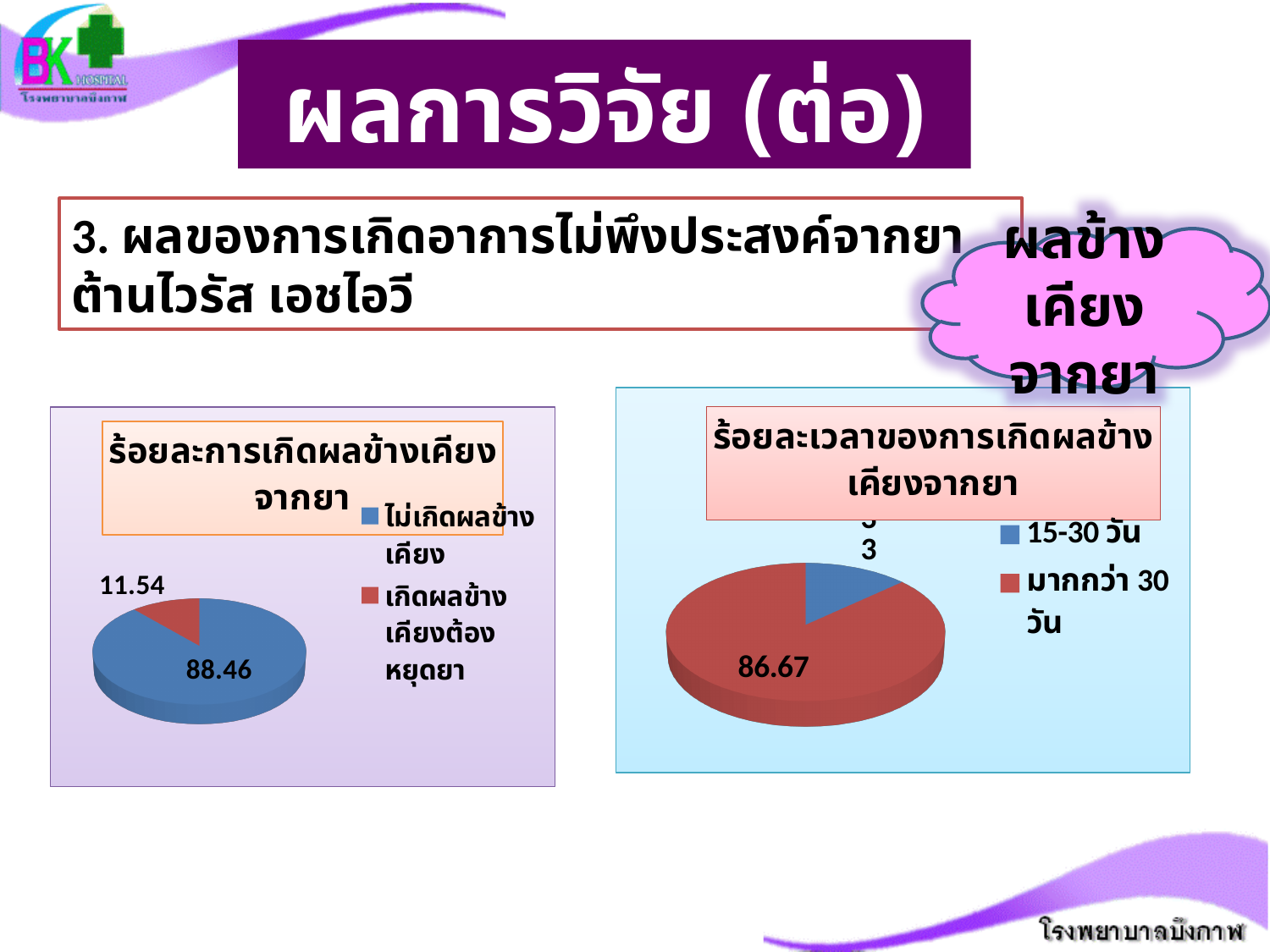
In the left chart "ร้อยละการเกิดผลข้างเคียงจากยา", what is the value for "เกิดผลข้างเคียงต้องหยุดยา"? 11.54 How many slices does the left chart "ร้อยละการเกิดผลข้างเคียงจากยา" have? 2 In the left chart "ร้อยละการเกิดผลข้างเคียงจากยา", which category has the largest slice? ไม่เกิดผลข้างเคียง In the right chart "ร้อยละเวลาของการเกิดผลข้างเคียงจากยา", what is the value for "มากกว่า 30 วัน"? 86.67 What kind of chart is the left chart titled "ร้อยละการเกิดผลข้างเคียงจากยา"? Pie chart In the right chart "ร้อยละเวลาของการเกิดผลข้างเคียงจากยา", which is larger: the slice for "15-30 วัน" or the slice for "มากกว่า 30 วัน"? มากกว่า 30 วัน In the left chart "ร้อยละการเกิดผลข้างเคียงจากยา", what is the value for "ไม่เกิดผลข้างเคียง"? 88.46 In the right chart "ร้อยละเวลาของการเกิดผลข้างเคียงจากยา", what colour is the slice for "มากกว่า 30 วัน"? Red In the left chart "ร้อยละการเกิดผลข้างเคียงจากยา", which category has the smallest slice? เกิดผลข้างเคียงต้องหยุดยา In the right chart "ร้อยละเวลาของการเกิดผลข้างเคียงจากยา", which category has the largest slice? มากกว่า 30 วัน What kind of chart is the right chart titled "ร้อยละเวลาของการเกิดผลข้างเคียงจากยา"? Pie chart In the left chart "ร้อยละการเกิดผลข้างเคียงจากยา", what is the difference between the values for "ไม่เกิดผลข้างเคียง" and "เกิดผลข้างเคียงต้องหยุดยา"? 76.92